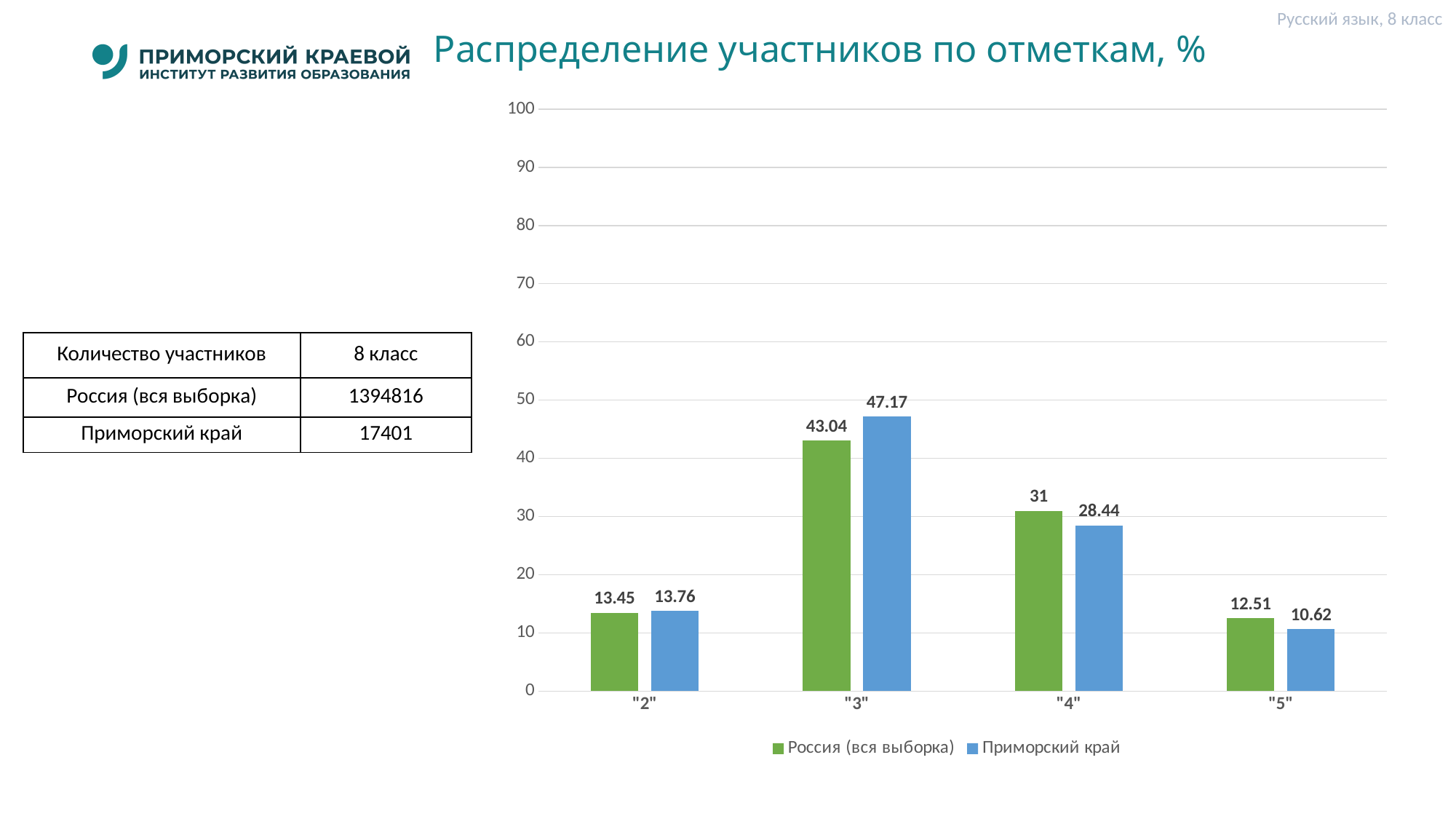
What is the value for Приморский край for mark "4"? 28.44 What is the value for Приморский край for mark "5"? 10.62 What is the title of the chart? Распределение участников по отметкам, % How many series does the legend list? 2 Which mark has the highest value for Приморский край? "3" How many mark categories are shown on the x axis? 4 What kind of chart is shown on the slide? bar chart What is the value for Россия (вся выборка) for mark "3"? 43.04 Which mark has the lowest value for Россия (вся выборка)? "5" What is the difference between Приморский край and Россия (вся выборка) for mark "3"? 4.13 Which is larger for mark "4": Россия (вся выборка) or Приморский край? Россия (вся выборка) Is the value for Россия (вся выборка) for mark "2" greater or less than 20? less